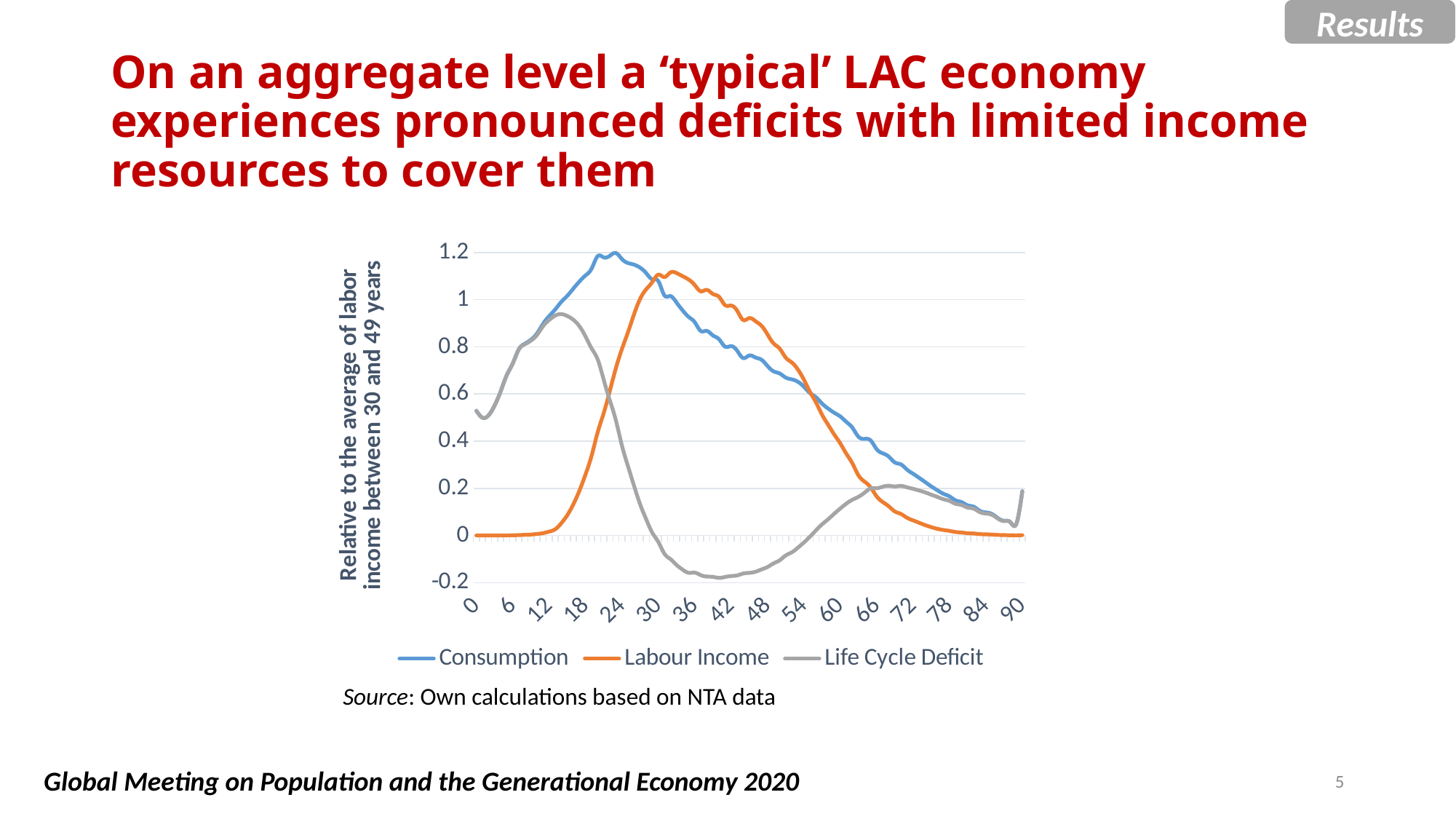
Which series is shown in orange in the legend? Labour Income Is the value for Consumption at age 24 greater or less than 1? greater Is the value for Labour Income at age 60 greater or less than 0.6? less What is the y-axis title of the chart? Relative to the average of labor income between 30 and 49 years Is the value for Labour Income at age 12 greater or less than 0.2? less Does Labour Income rise or fall between age 36 and age 90? fall How many series does the legend list? 3 At age 12, which is larger: Consumption or Labour Income? Consumption At age 66, which is larger: Consumption or Labour Income? Consumption What kind of chart is shown on the slide? line chart